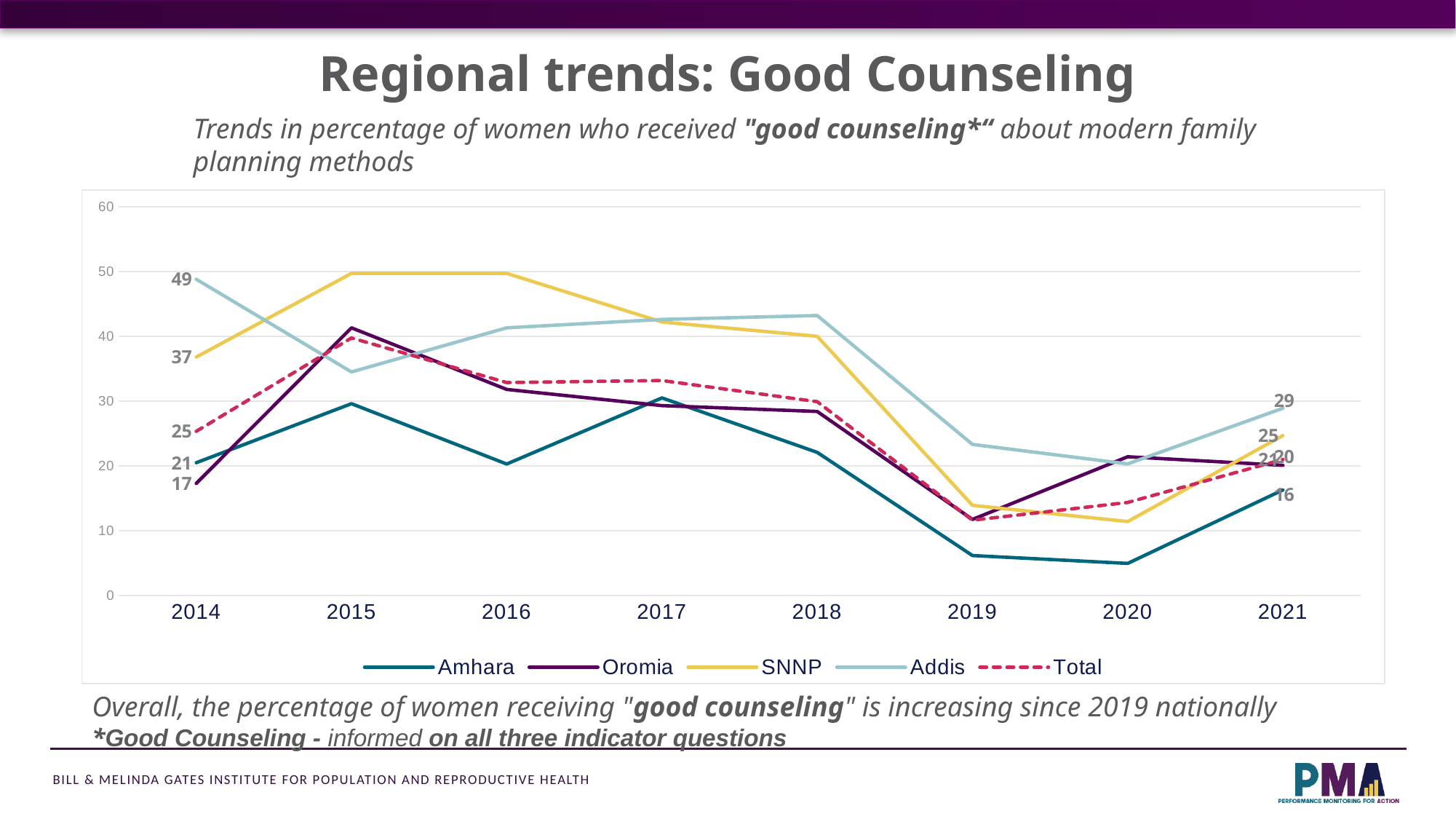
What kind of chart is shown on the slide? line chart Which region has the highest value in 2014? Addis What is the difference between the Addis value in 2014 and in 2021? 20 How many years are plotted along the x axis? 8 What is the value for Oromia in 2014? 17 What is the value for Amhara in 2021? 16 What is the value for SNNP in 2014? 37 Is the value for SNNP in 2015 greater or less than 40? greater Which region has the lowest value in 2014? Oromia Does the Amhara line rise or fall from 2019 to 2021? rise What is the value for Addis in 2014? 49 How many series does the legend list? 5